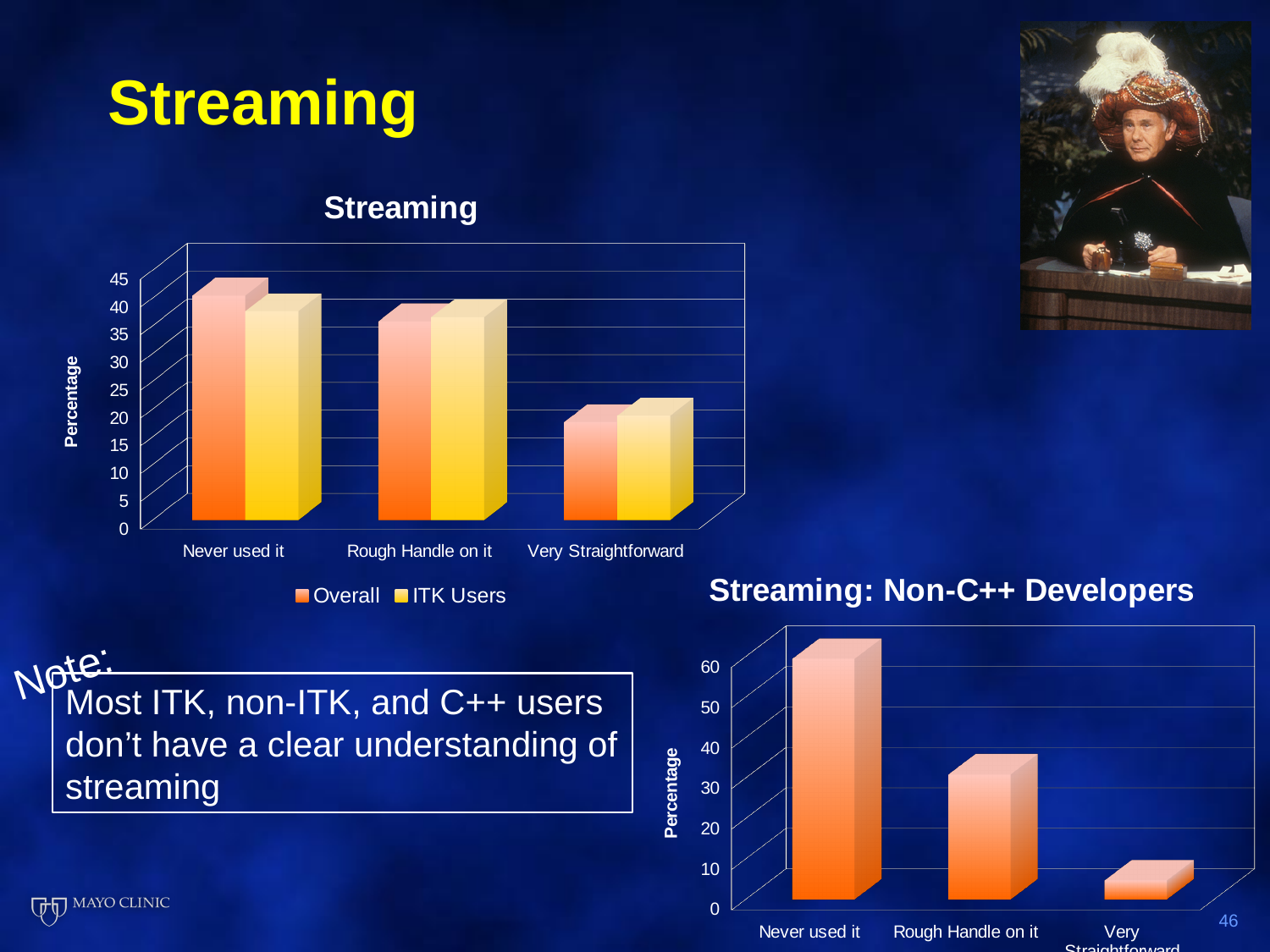
In the 'Streaming' chart, which category has the lowest values for both series? Very Straightforward In the 'Streaming: Non-C++ Developers' chart, which category has the lowest value? Very Straightforward What are the two series named in the legend of the 'Streaming' chart? Overall and ITK Users What is the title of the chart in the bottom right of the slide? Streaming: Non-C++ Developers In the 'Streaming: Non-C++ Developers' chart, do the values rise or fall from left to right along the x axis? fall In the 'Streaming: Non-C++ Developers' chart, which category has the highest value? Never used it How many series does the legend of the 'Streaming' chart list? 2 In the 'Streaming' chart, is the Overall value for 'Never used it' greater or less than 35? greater How many categories are shown on the x axis of the 'Streaming' chart? 3 In the 'Streaming' chart, is the Overall value for 'Very Straightforward' greater or less than 25? less In the 'Streaming: Non-C++ Developers' chart, is the value for 'Rough Handle on it' greater or less than 40? less What kind of chart is the 'Streaming' chart on the left? bar chart